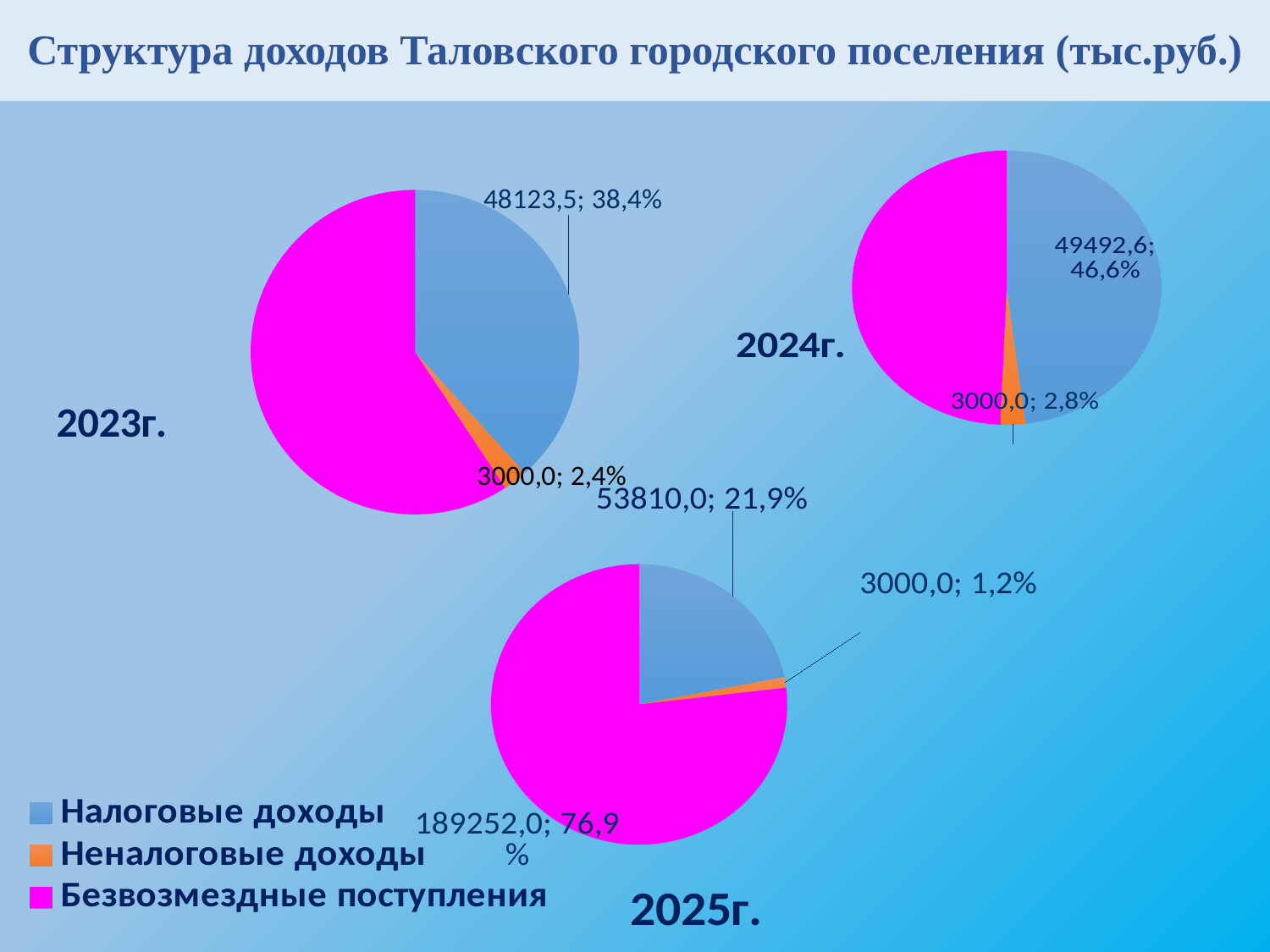
What is the difference between the Налоговые доходы value in the 2024 chart and in the 2023 chart? 1369,1 In the 2025 pie chart, what value is shown for Безвозмездные поступления? 189252,0 What type of chart is used on this slide? Pie chart In the 2024 pie chart, what share of the pie is Налоговые доходы? 46,6% Which is larger: the Налоговые доходы value in the 2025 chart or in the 2023 chart? 2025 In the 2025 pie chart, which category has the largest slice? Безвозмездные поступления In the 2023 pie chart, what share of the pie is Неналоговые доходы? 2,4% In the 2024 pie chart, what value is shown for Налоговые доходы? 49492,6 In the 2024 pie chart, which category has the smallest slice? Неналоговые доходы In the 2023 pie chart, what value is shown for Налоговые доходы? 48123,5 In the 2025 pie chart, what share of the pie is Налоговые доходы? 21,9% How many categories does the legend list? 3